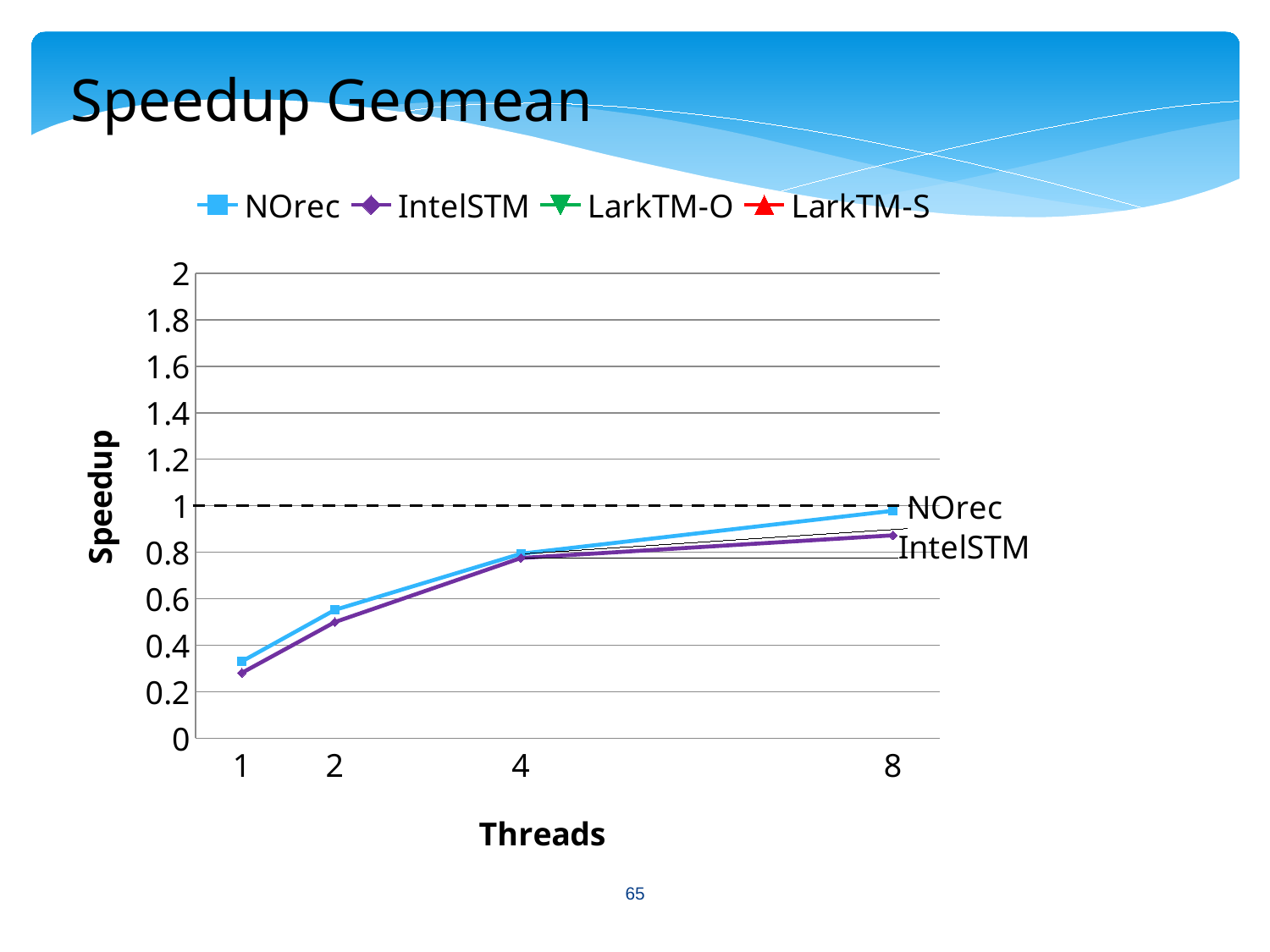
What is the label of the y axis? Speedup At 8 threads, which series has the higher speedup, NOrec or IntelSTM? NOrec Is the IntelSTM speedup at 2 threads greater or less than 0.6? less Does the NOrec speedup rise or fall as the number of threads increases? rise Does the IntelSTM speedup rise or fall as the number of threads increases? rise What is the title of the chart? Speedup Geomean Is the NOrec speedup at 4 threads greater or less than 0.6? greater How many series does the legend list? 4 What kind of chart is shown on the slide? line chart How many thread counts are shown on the x axis? 4 Is the IntelSTM speedup at 8 threads greater or less than 0.8? greater